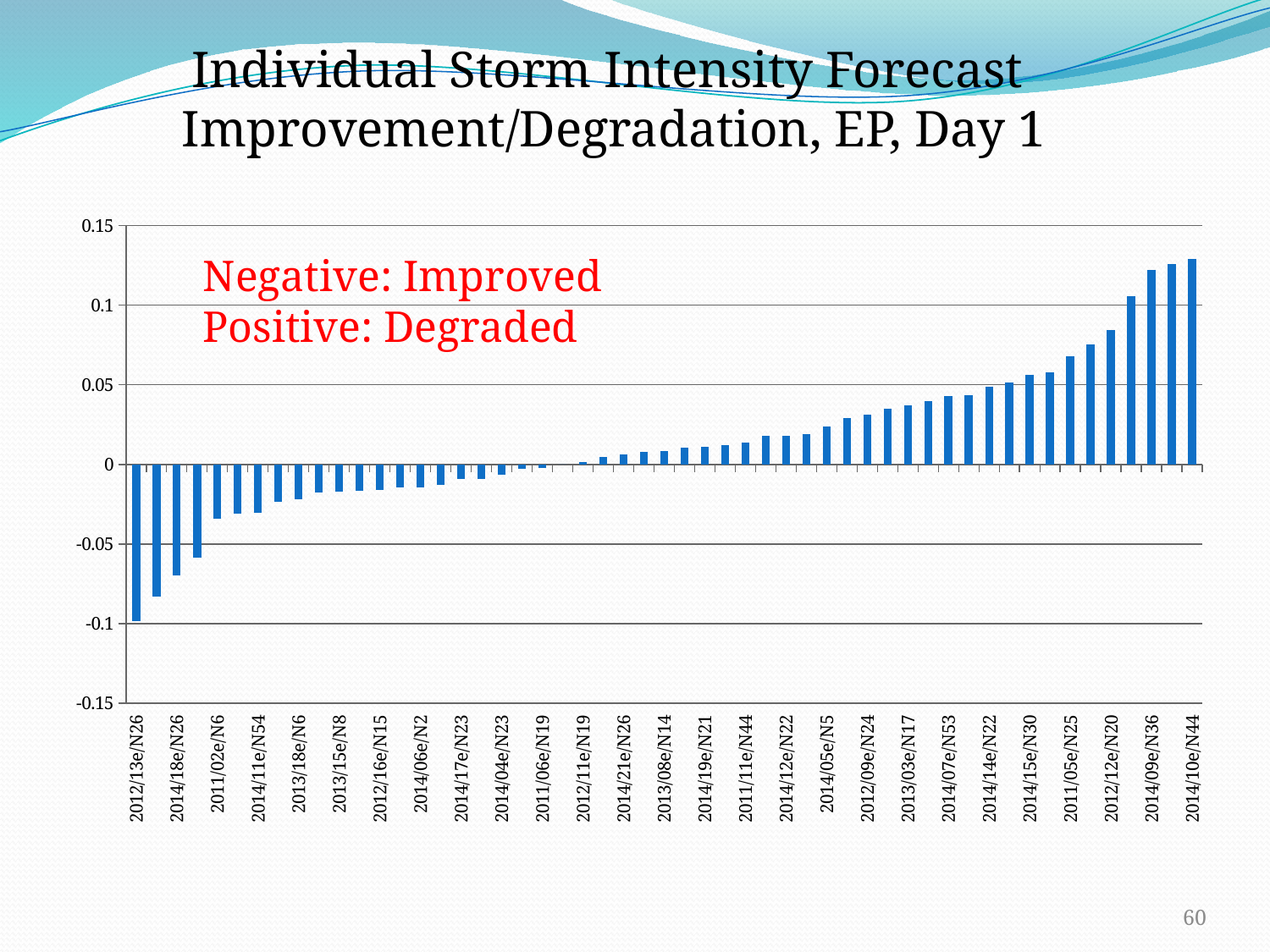
Which storm has the highest value on the chart? 2014/10e/N44 Which has the larger value, 2014/09e/N36 or 2011/05e/N25? 2014/09e/N36 Is the value for 2014/18e/N26 greater or less than -0.05? less Is the value for 2012/13e/N26 greater or less than -0.05? less What kind of chart is shown on the slide? bar chart Do the bar values rise or fall from left to right along the x axis? rise Is the value for 2014/11e/N54 greater or less than -0.05? greater Which storm has the lowest value on the chart? 2012/13e/N26 Which has the larger value, 2014/10e/N44 or 2012/13e/N26? 2014/10e/N44 According to the text on the chart, what does a negative value indicate? Improved